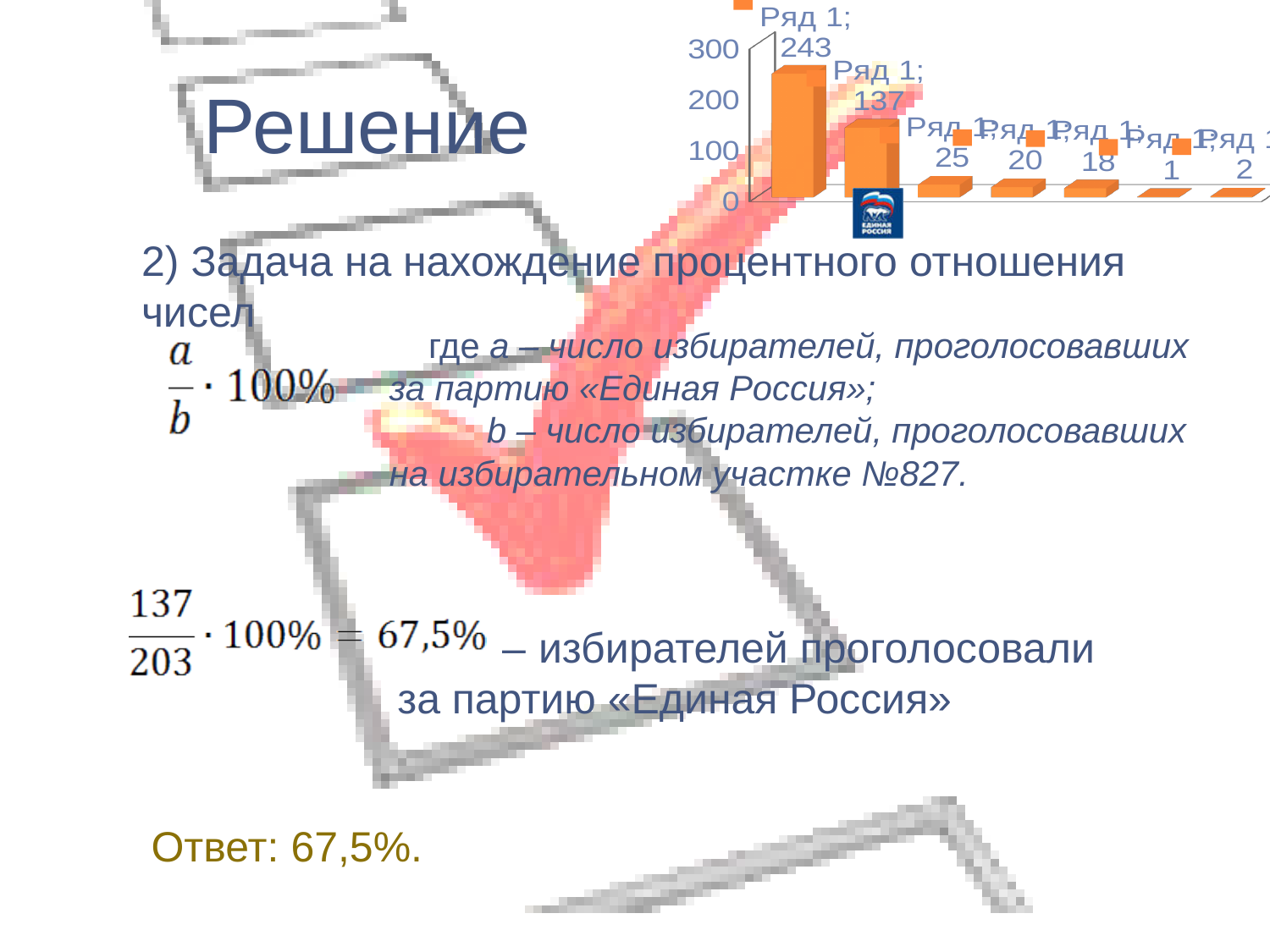
What kind of chart is shown on the slide? bar chart What is the value of the second bar in the chart, the one marked with the Единая Россия logo? 137 Which is larger, the value of the third bar or the value of the fourth bar? the third bar (25) What is the value of the third bar in the chart? 25 What is the highest tick value shown on the vertical axis of the chart? 300 How many bars are plotted in the chart? 7 What is the value of the fifth bar in the chart? 18 What is the value of the first (tallest) bar in the chart? 243 Is the value of the first bar greater or less than 200? greater What is the lowest value shown in the chart? 1 What is the difference between the first bar (243) and the second bar (137)? 106 What is the highest value shown in the chart? 243